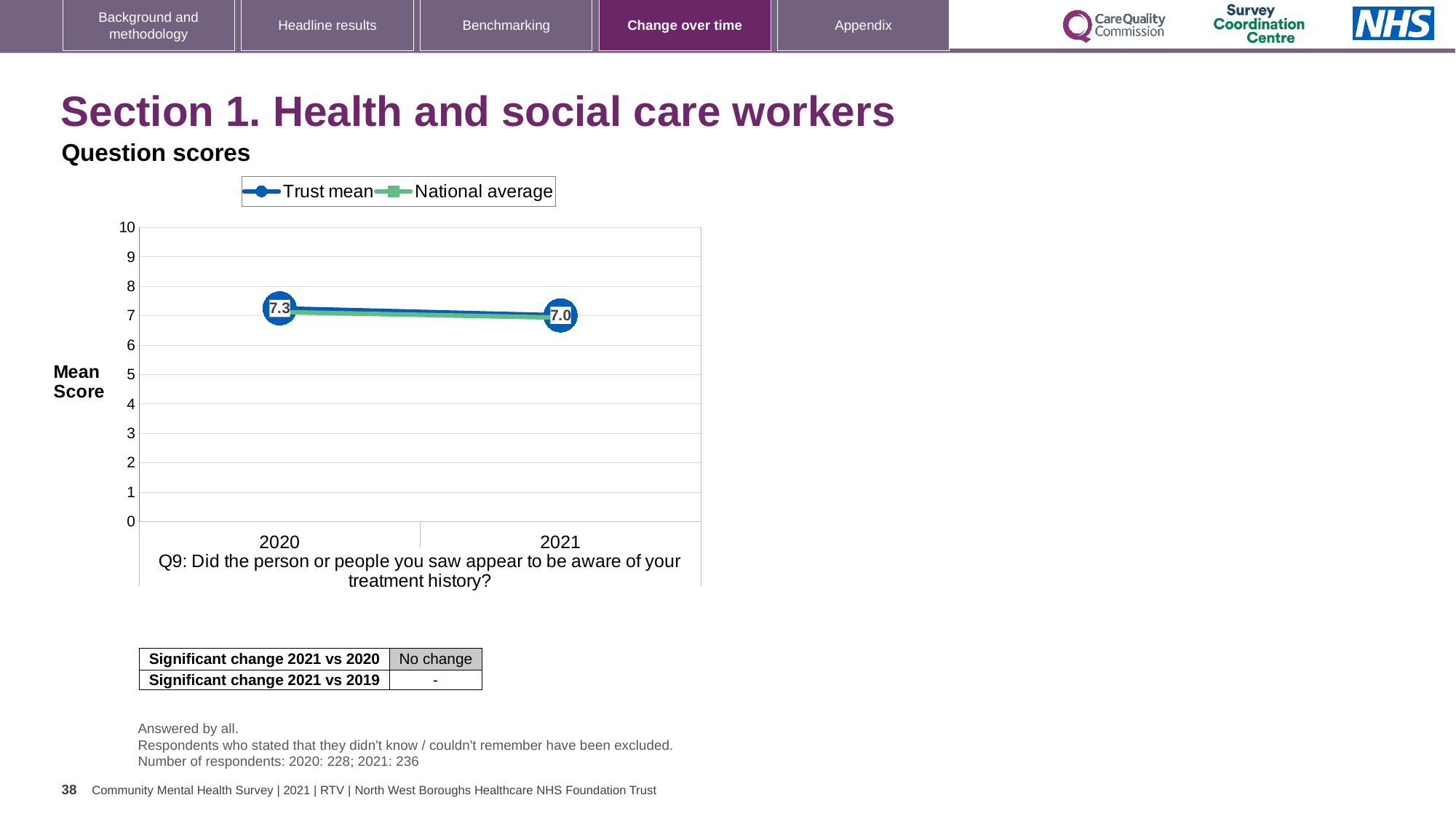
What is the difference between the Trust mean scores for 2020 and 2021? 0.3 What kind of chart is shown on the slide? Line chart Is the National average value for 2021 greater or less than 5? greater Which is larger, the Trust mean for 2020 or the Trust mean for 2021? 2020 How many series does the chart legend list? 2 What is the Trust mean score for 2021? 7.0 In which year is the Trust mean score lower? 2021 How many years are plotted on the x axis of the chart? 2 Is the Trust mean value for 2020 greater or less than 8? less Does the Trust mean rise or fall from 2020 to 2021? Fall In which year is the Trust mean score higher? 2020 What is the Trust mean score for 2020? 7.3